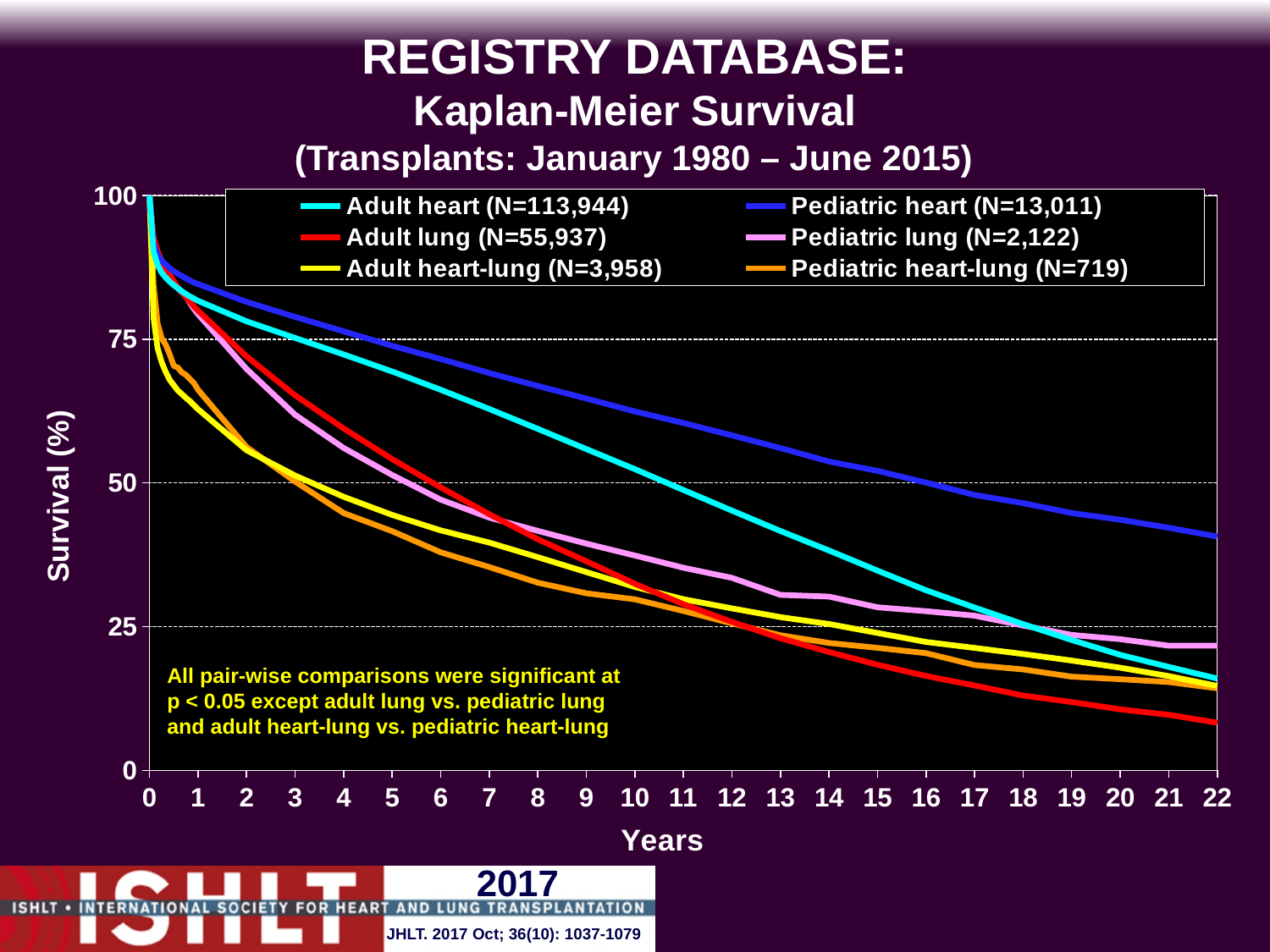
Which series has the highest survival at 22 years? Pediatric heart What is the label of the y axis? Survival (%) Is the survival for Adult lung at 22 years greater or less than 25? less Is the survival for Adult heart-lung at 5 years greater or less than 50? less What kind of chart is shown on the slide? line chart At 22 years, which is higher: Pediatric heart or Adult lung? Pediatric heart According to the legend, what is N for Adult heart? 113,944 How many series does the legend list? 6 Do the survival curves rise or fall as years increase? fall Is the survival for Pediatric heart at 22 years greater or less than 25? greater Which series has the lowest survival at 22 years? Adult lung